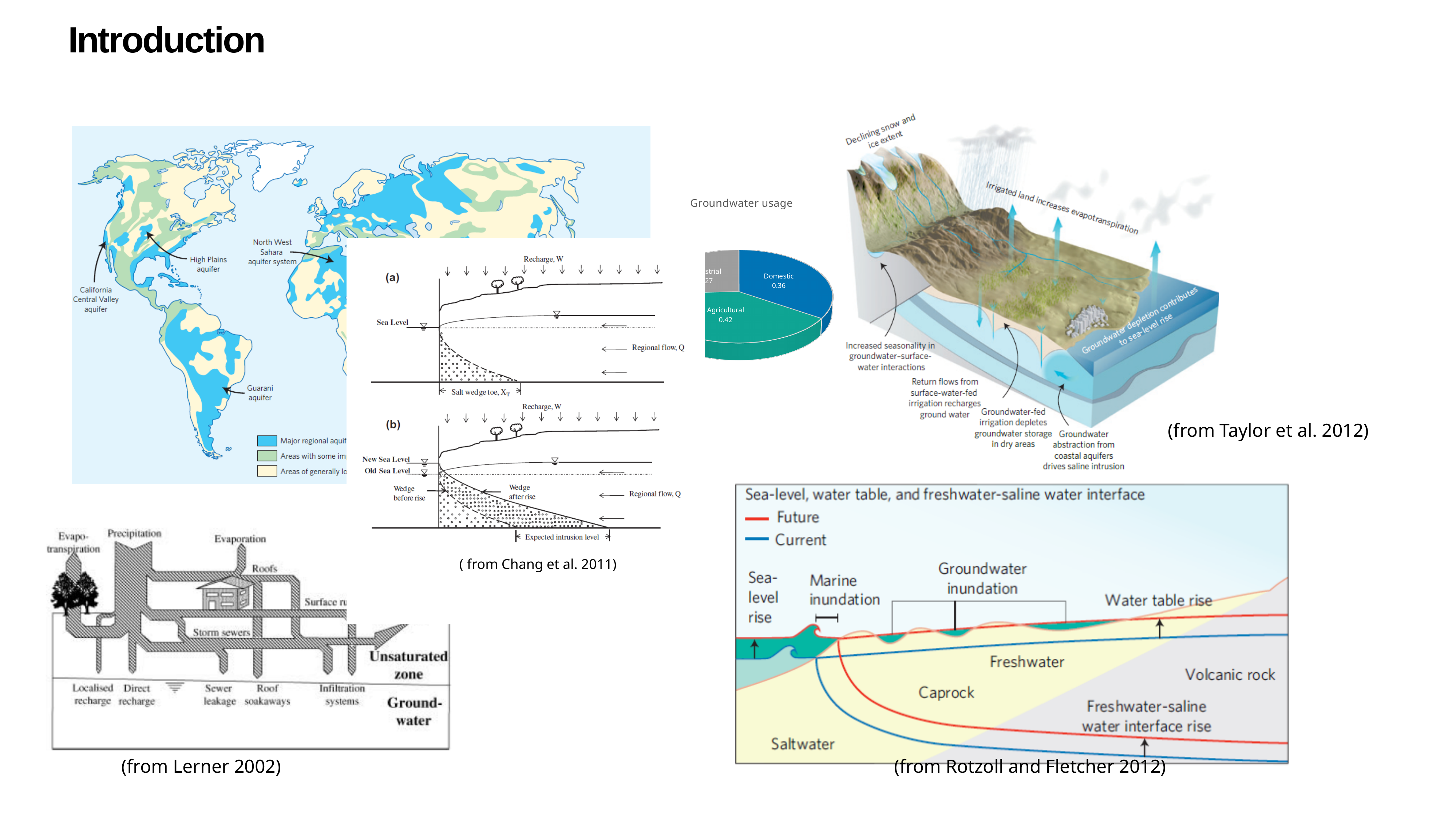
In the Groundwater usage pie chart, which is larger, Agricultural or Domestic? Agricultural In the Groundwater usage pie chart, what is the value for Agricultural? 0.42 What is the title of the pie chart on the slide? Groundwater usage How many slices does the Groundwater usage pie chart have? 3 In the Groundwater usage pie chart, what is the difference between the Agricultural and Domestic values? 0.06 In the Groundwater usage pie chart, which labelled slice has the largest value? Agricultural In the Groundwater usage pie chart, what is the value for Domestic? 0.36 What kind of chart is the Groundwater usage chart? Pie chart